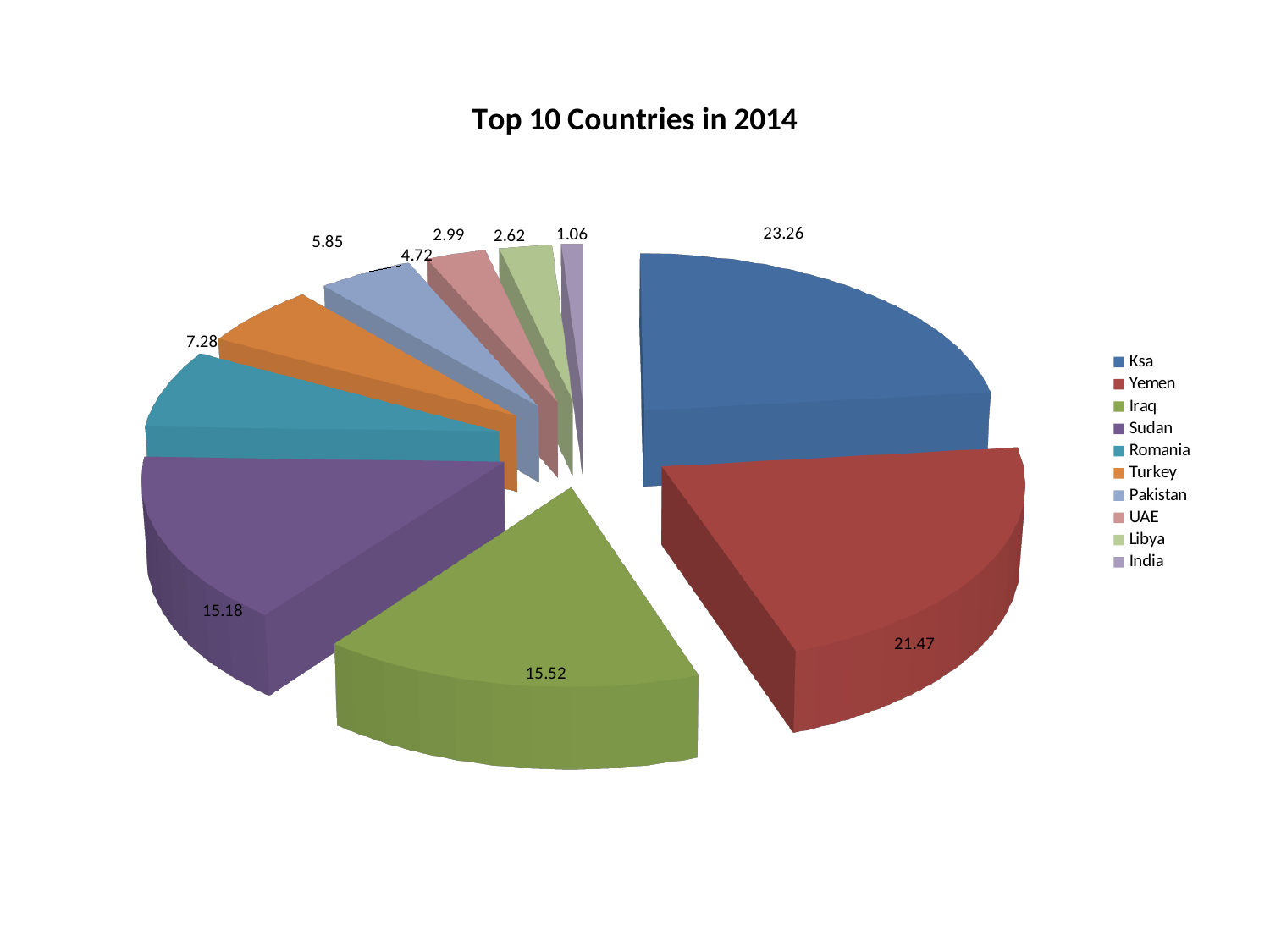
Which is larger, the value for Turkey or the value for Pakistan? Turkey What is the title of the chart? Top 10 Countries in 2014 What is the value for Pakistan? 4.72 Which country has the largest slice? Ksa What colour is the slice for Iraq? green What is the value for Yemen? 21.47 How many countries does the legend list? 10 What is the value for Romania? 7.28 What type of chart is shown on the slide? pie chart Which country has the smallest slice? India What is the difference between the values for Ksa and Yemen? 1.79 What is the value for Ksa? 23.26